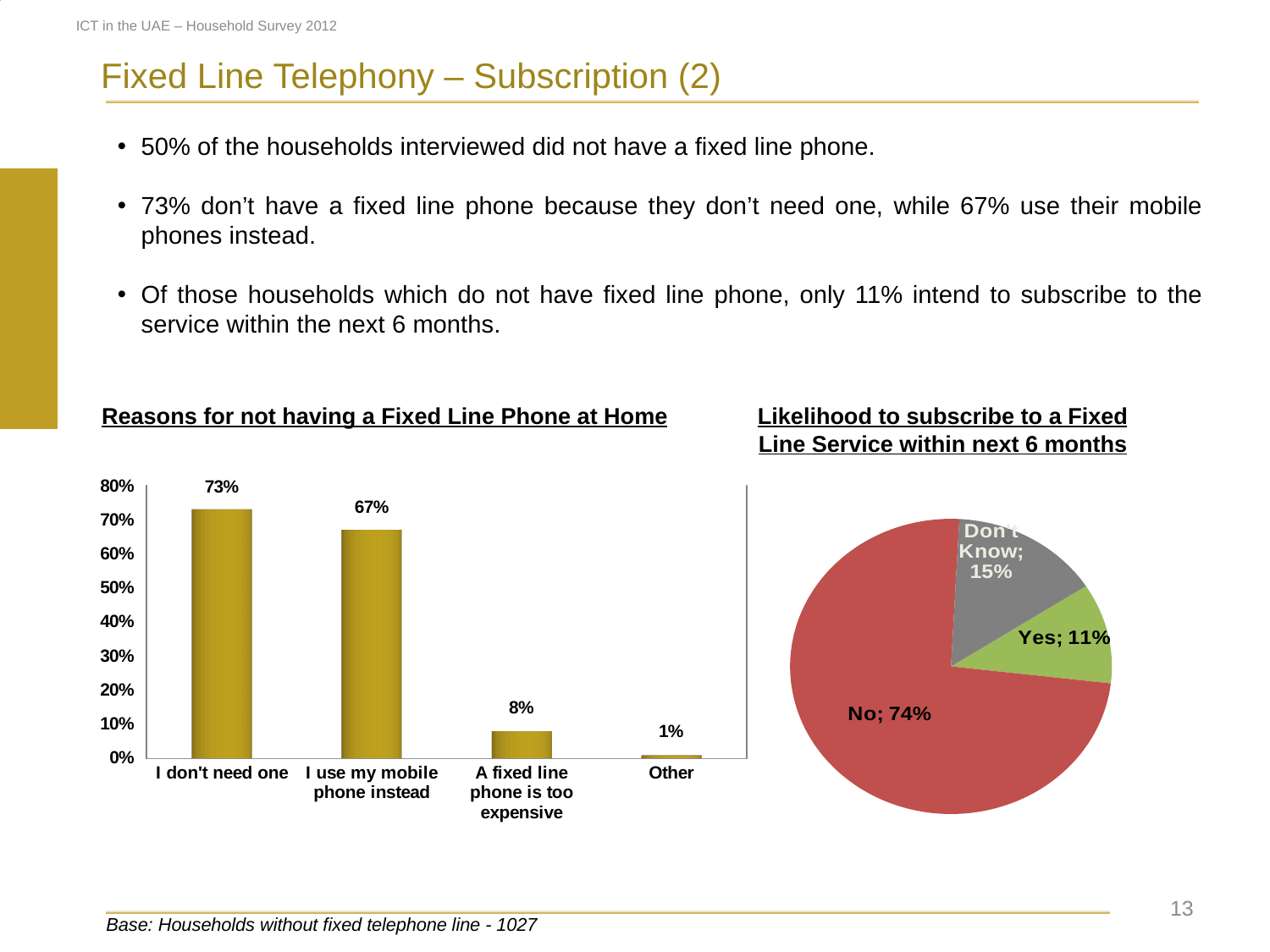
In the 'Reasons for not having a Fixed Line Phone at Home' chart, how many reasons are shown? 4 In the 'Reasons for not having a Fixed Line Phone at Home' chart, what is the value for 'I don't need one'? 73% In the 'Likelihood to subscribe to a Fixed Line Service within next 6 months' chart, what share of respondents answered 'Don't Know'? 15% In the 'Reasons for not having a Fixed Line Phone at Home' chart, what is the value for 'A fixed line phone is too expensive'? 8% What kind of chart is the 'Likelihood to subscribe to a Fixed Line Service within next 6 months' chart? Pie chart In the 'Likelihood to subscribe to a Fixed Line Service within next 6 months' chart, what share of respondents answered 'No'? 74% In the 'Likelihood to subscribe to a Fixed Line Service within next 6 months' chart, which is larger: 'Yes' or 'Don't Know'? Don't Know In the 'Reasons for not having a Fixed Line Phone at Home' chart, which reason has the lowest value? Other In the 'Reasons for not having a Fixed Line Phone at Home' chart, which reason has the highest value? I don't need one In the 'Reasons for not having a Fixed Line Phone at Home' chart, what is the difference between 'I don't need one' and 'I use my mobile phone instead'? 6% In the 'Likelihood to subscribe to a Fixed Line Service within next 6 months' chart, how many slices does the pie have? 3 What kind of chart is the 'Reasons for not having a Fixed Line Phone at Home' chart? Bar chart